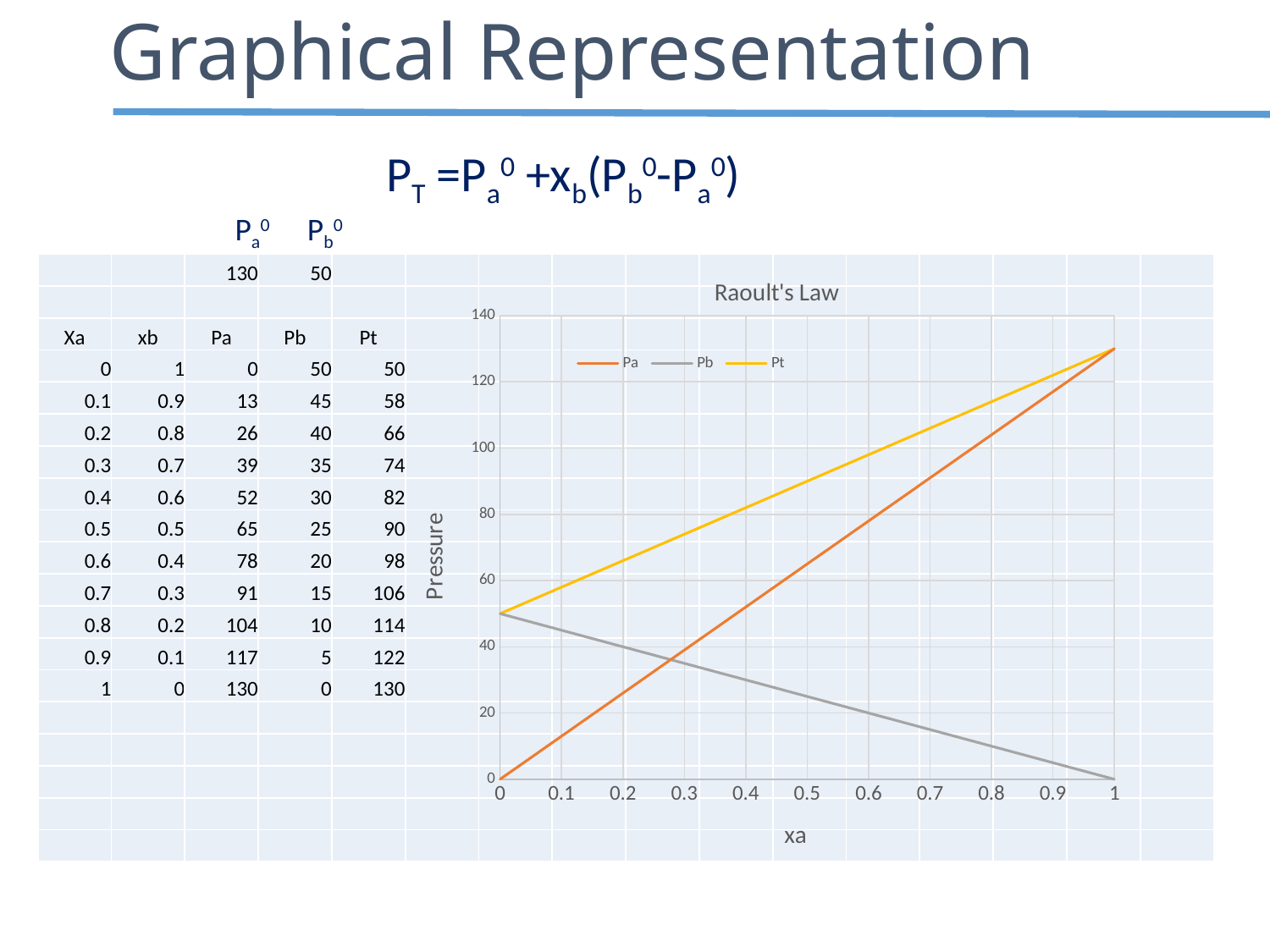
How many series does the chart legend list? 3 Is the value of Pt at xa = 0.5 greater or less than 80? greater Does the Pb series rise or fall as xa increases along the x axis? fall According to the slide, what is the value of Pt at xa = 0.5? 90 Does the Pt series rise or fall as xa increases along the x axis? rise What is the title of the chart? Raoult's Law At xa = 0.2, which series has the larger value, Pa or Pb? Pb At xa = 0.9, which series has the larger value, Pa or Pb? Pa What type of chart is shown on the slide? line chart Is the value of Pb at xa = 0.8 greater or less than 20? less What is the label of the chart's y axis? Pressure According to the slide, what is the value of Pa at xa = 1? 130